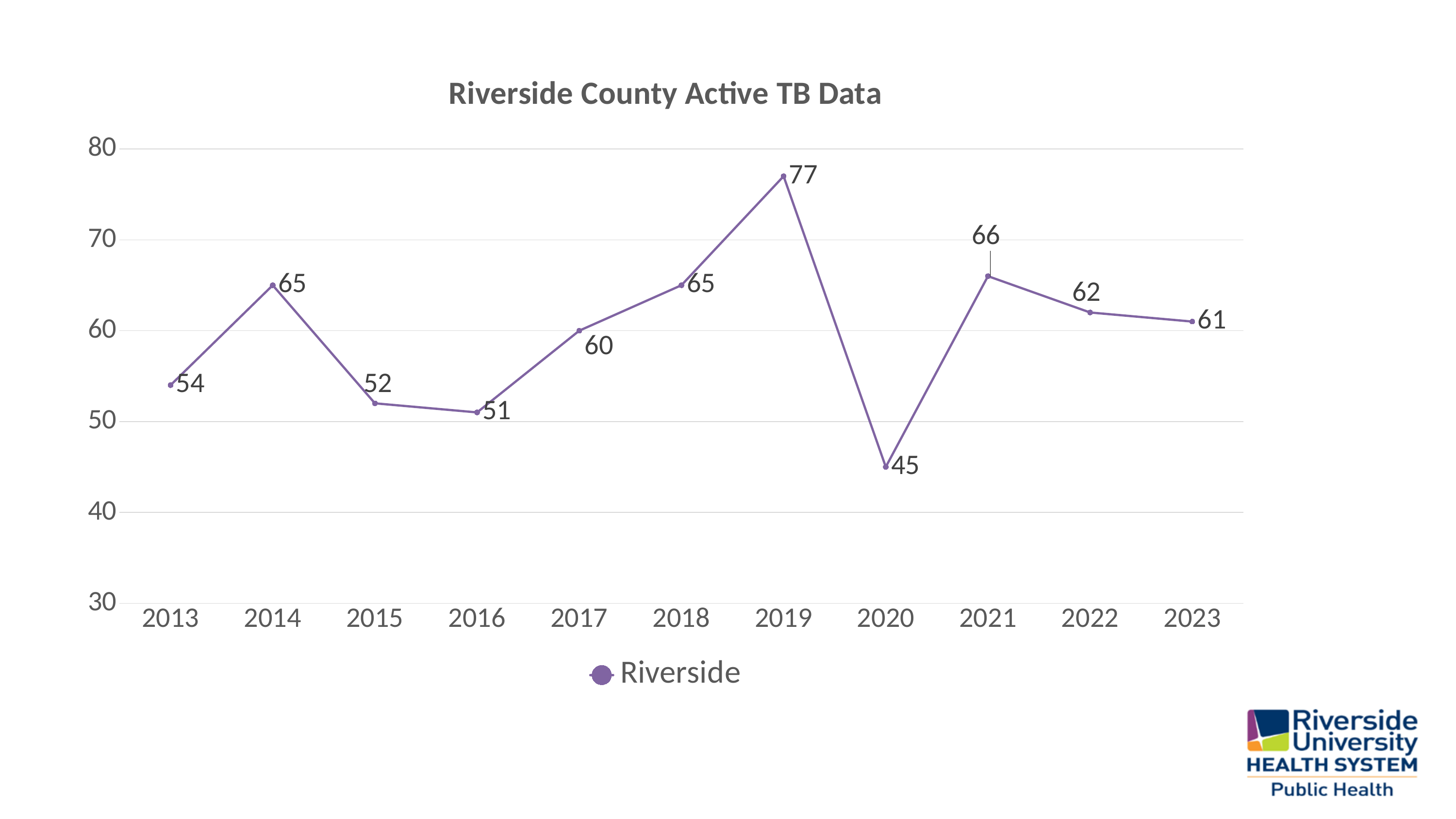
What is the value for 2019? 77 What is the value for 2020? 45 How many series does the legend list? 1 Which year has the lowest value? 2020 What is the value for 2013? 54 What kind of chart is this? line chart What is the title of the chart? Riverside County Active TB Data How many years are plotted on the x axis? 11 What is the difference between the values for 2019 and 2020? 32 Which is larger, the value for 2014 or the value for 2015? 2014 Which year has the highest value? 2019 Is the value for 2021 greater or less than 60? greater